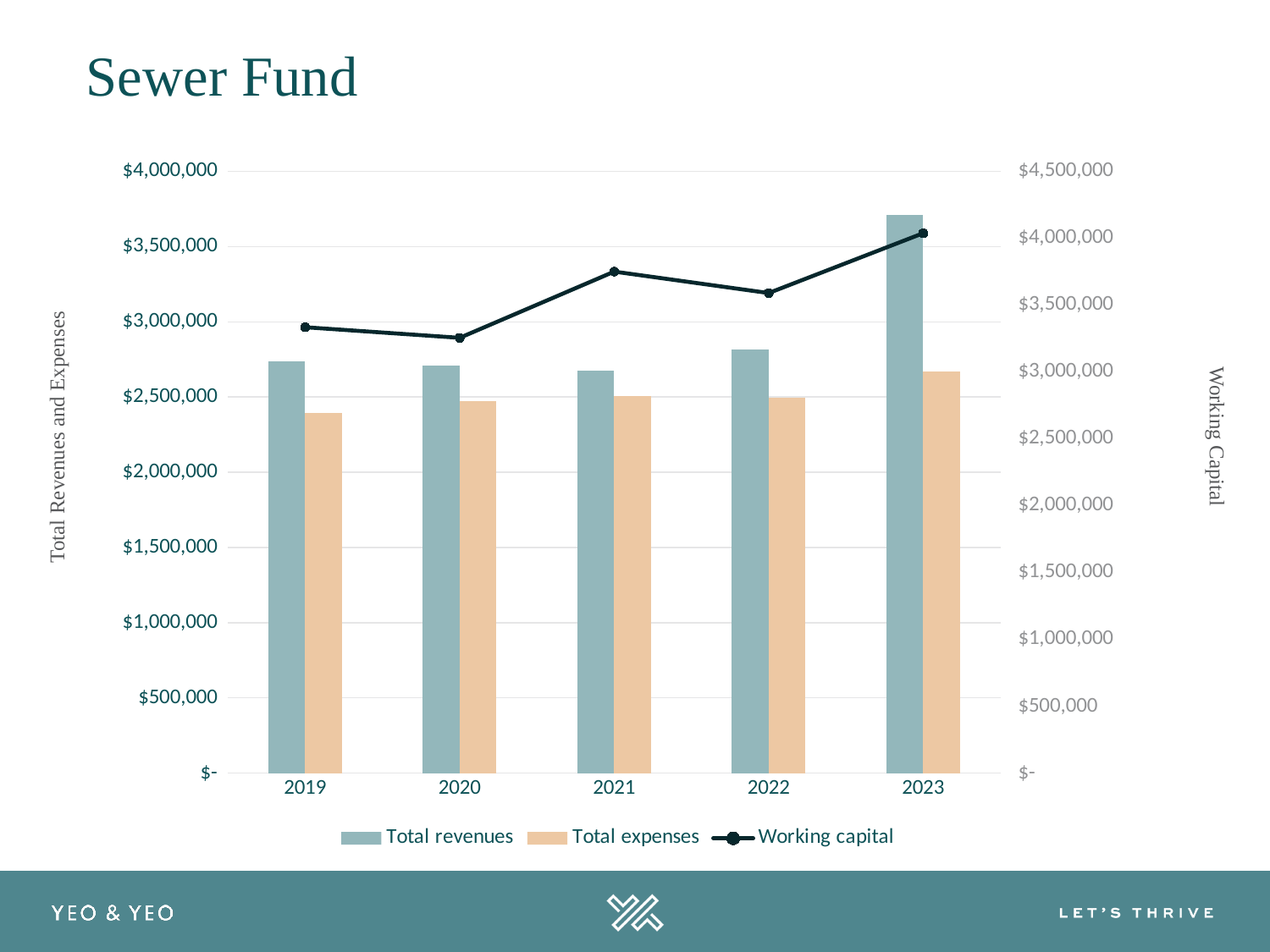
In 2023, which is larger: Total revenues or Total expenses? Total revenues Is the Working capital value for 2021 greater or less than $3,500,000 on the right axis? greater What is the title of the chart on the slide? Sewer Fund What is the title of the right-hand vertical axis? Working Capital Which year has the lowest Total expenses? 2019 Which year has the highest Working capital? 2023 Is the value for Total revenues in 2023 greater or less than $3,500,000? greater Is the value for Total expenses in 2019 greater or less than $2,500,000? less What kind of chart is shown on the slide? Combined bar and line chart How many series does the legend list? 3 Which year has the highest Total revenues? 2023 How many years are shown on the x axis? 5